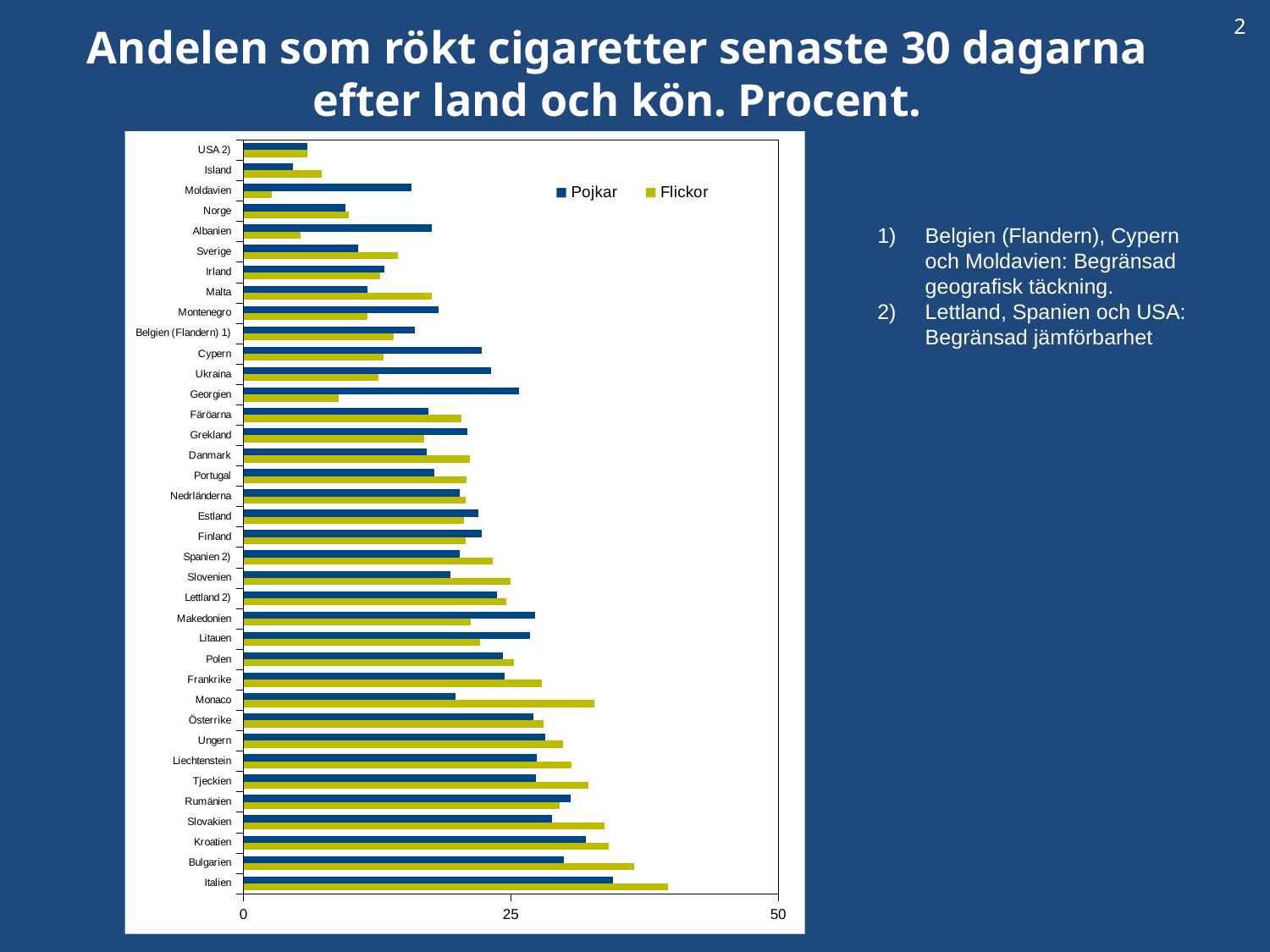
Which country has the highest value for Pojkar? Italien How many series does the legend list? 2 Is the value for Flickor in Italien greater or less than 25? greater How many countries are listed on the vertical axis of the chart? 37 Which country has the lowest value for Flickor? Moldavien What kind of chart is shown on the slide? Bar chart What are the two series named in the legend? Pojkar and Flickor Is the value for Pojkar in USA 2) greater or less than 25? less For Monaco, which is larger: the value for Pojkar or for Flickor? Flickor Is the value for Flickor in Monaco greater or less than 25? greater Which country has the highest value for Flickor? Italien For Moldavien, which is larger: the value for Pojkar or for Flickor? Pojkar